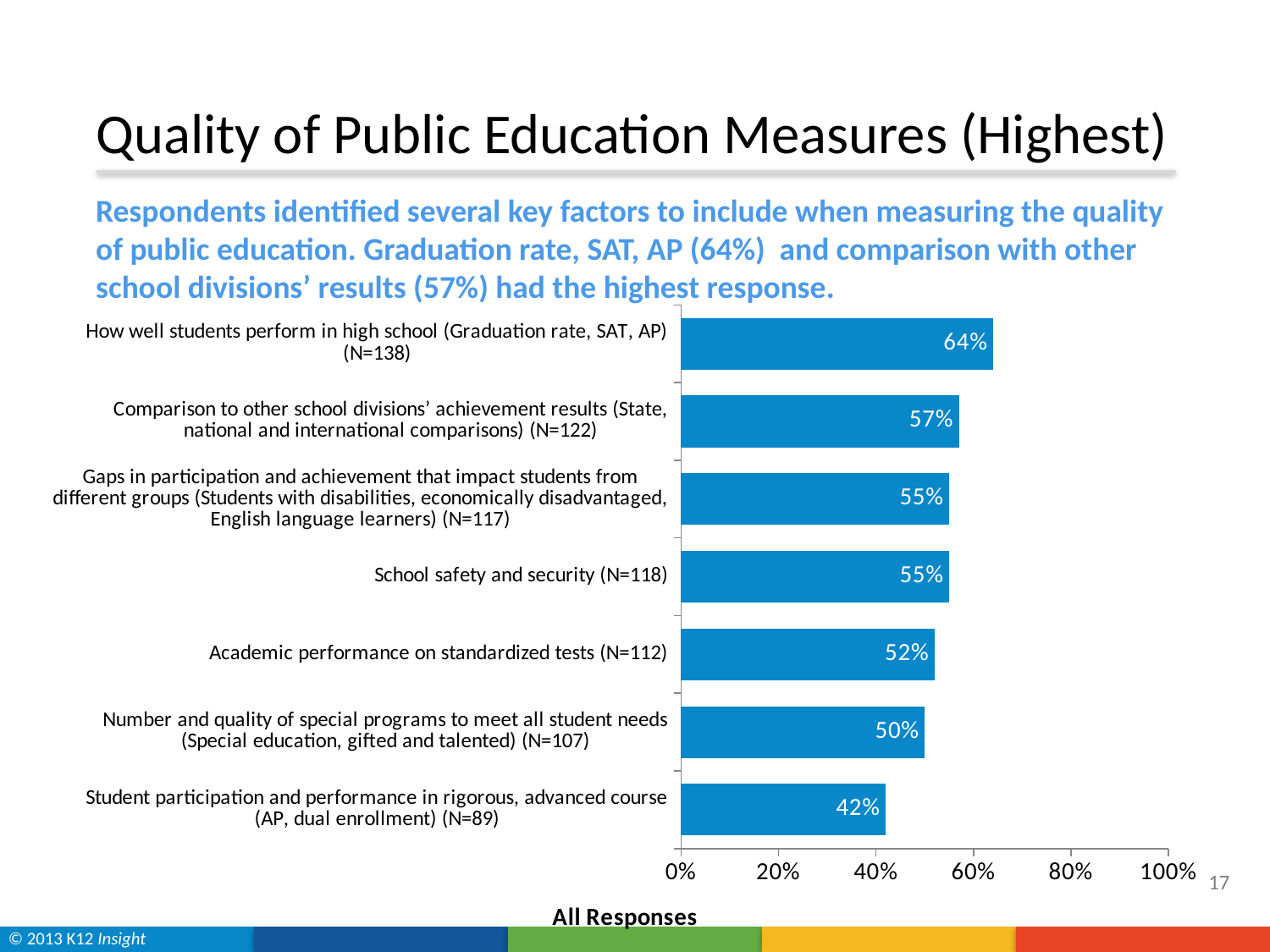
What is the difference between the value for 'How well students perform in high school' and the value for 'Comparison to other school divisions' achievement results'? 7% What is the maximum value shown on the x axis of the chart? 100% What is the value for 'School safety and security (N=118)'? 55% How many categories are shown in the chart? 7 Which is larger: the value for 'Academic performance on standardized tests' or the value for 'Number and quality of special programs to meet all student needs'? Academic performance on standardized tests What percentage of respondents selected 'How well students perform in high school (Graduation rate, SAT, AP)'? 64% What kind of chart is shown on the slide? Bar chart Is the value for 'Comparison to other school divisions' achievement results' greater or less than 40%? greater What is the label shown below the x axis of the chart? All Responses What is the value for 'Student participation and performance in rigorous, advanced course (AP, dual enrollment)'? 42% Which category has the lowest value in the chart? Student participation and performance in rigorous, advanced course (AP, dual enrollment) (N=89) Which category has the highest value in the chart? How well students perform in high school (Graduation rate, SAT, AP) (N=138)